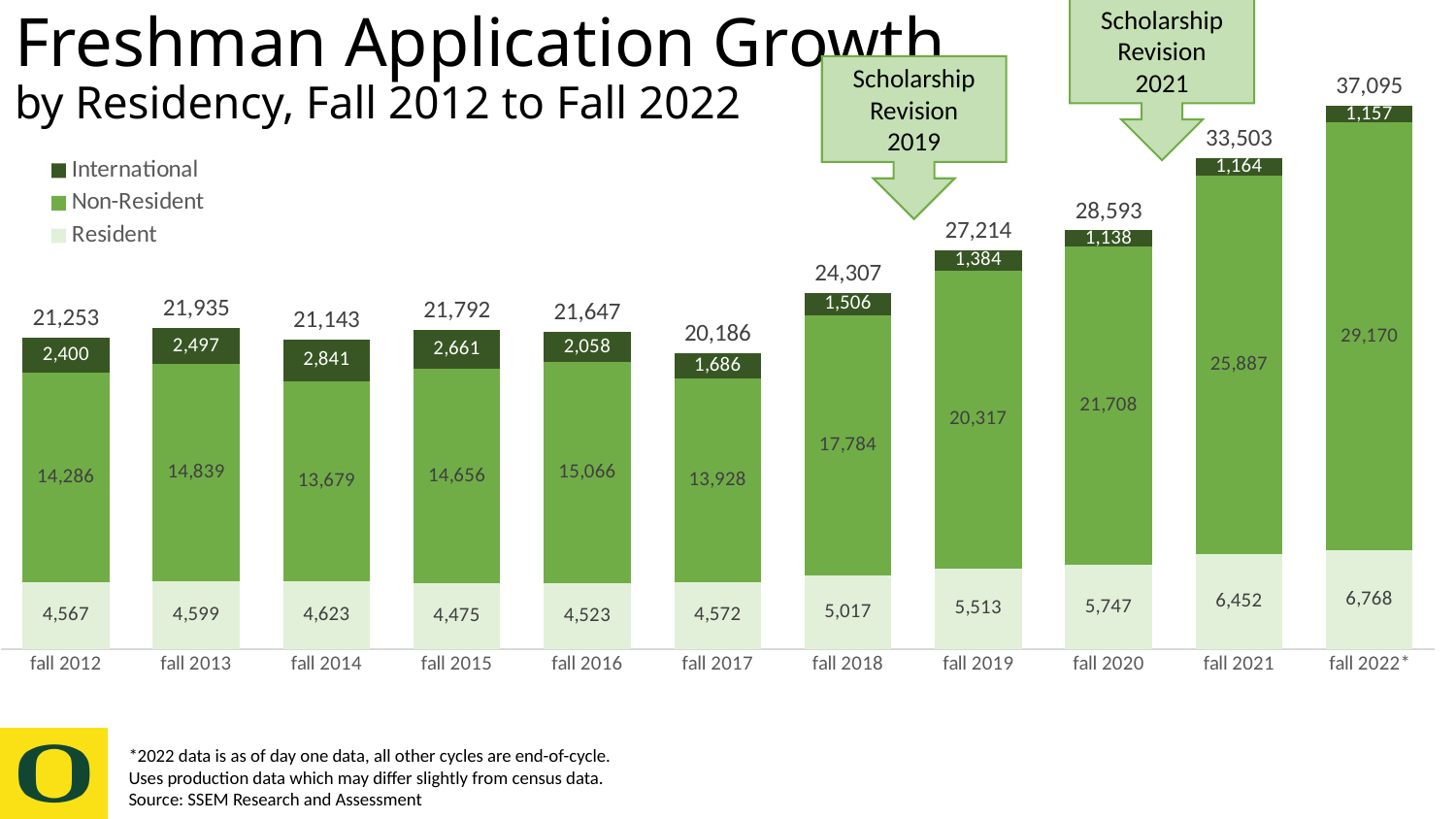
Do the Non-Resident values rise or fall from fall 2017 to fall 2022*? Rise What is the Resident value for fall 2015? 4,475 Which year has the highest total freshman applications? fall 2022* What is the International value for fall 2014? 2,841 What is the difference between the total for fall 2022* and the total for fall 2021? 3,592 What kind of chart is shown on the slide? Stacked bar chart How many series does the legend list? 3 Which year has the lowest total freshman applications? fall 2017 What is the total of the stacked bar for fall 2020? 28,593 How many fall terms are shown on the x axis? 11 What is the Non-Resident value for fall 2019? 20,317 Which is larger, the Resident value for fall 2018 or the Resident value for fall 2017? fall 2018